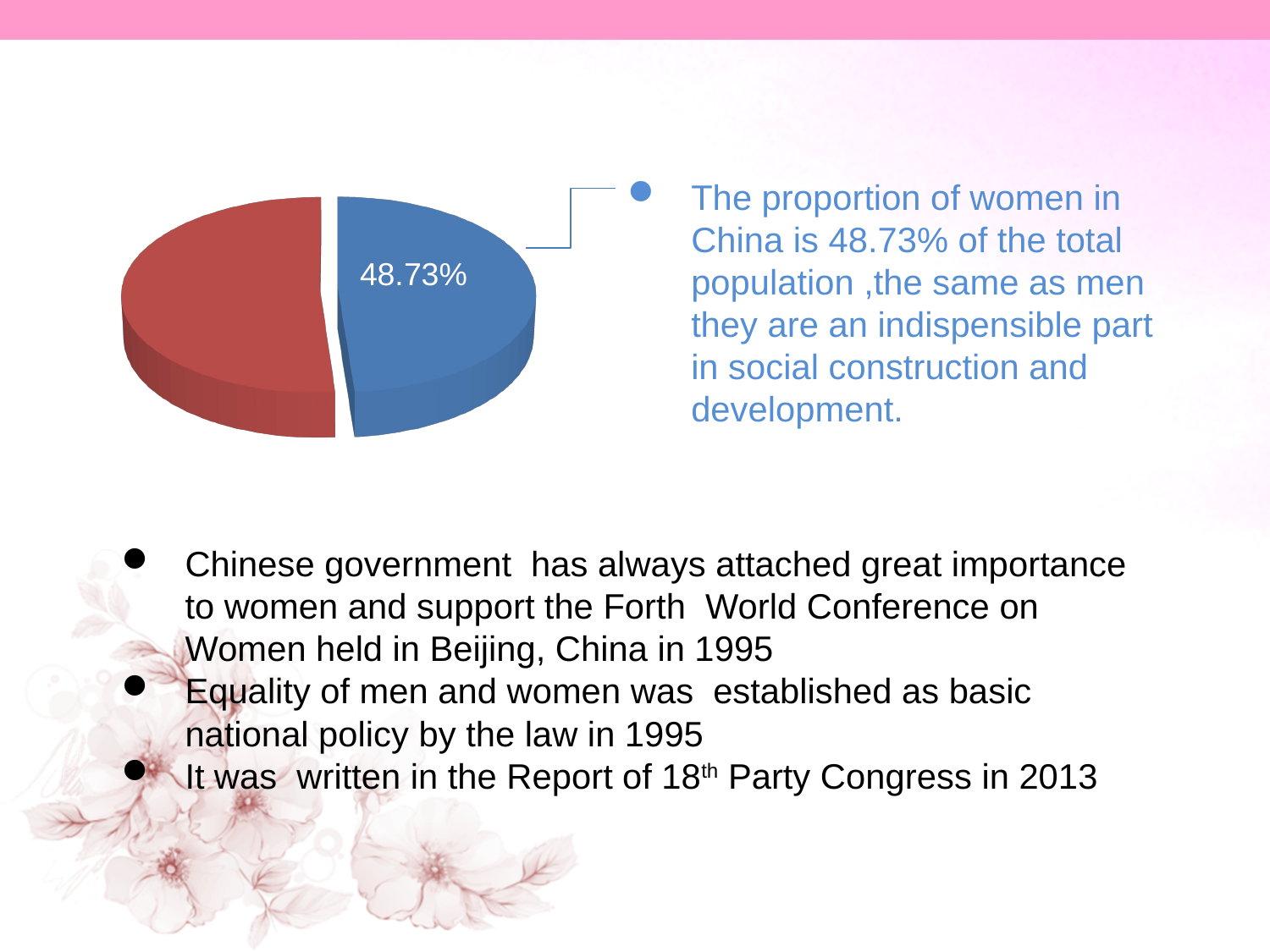
How many slices does the pie chart have? 2 What kind of chart is shown on the slide? pie chart According to the slide text, what does the 48.73% slice of the pie chart represent? the proportion of women in China's total population What colour is the slice labelled 48.73% in the pie chart? blue Is the labelled blue slice of the pie chart greater or less than 50% of the pie? less What value is printed on the blue slice of the pie chart? 48.73% What share of the pie does the labelled blue slice represent? 48.73% Which slice of the pie chart is larger, the blue one or the red one? the red one